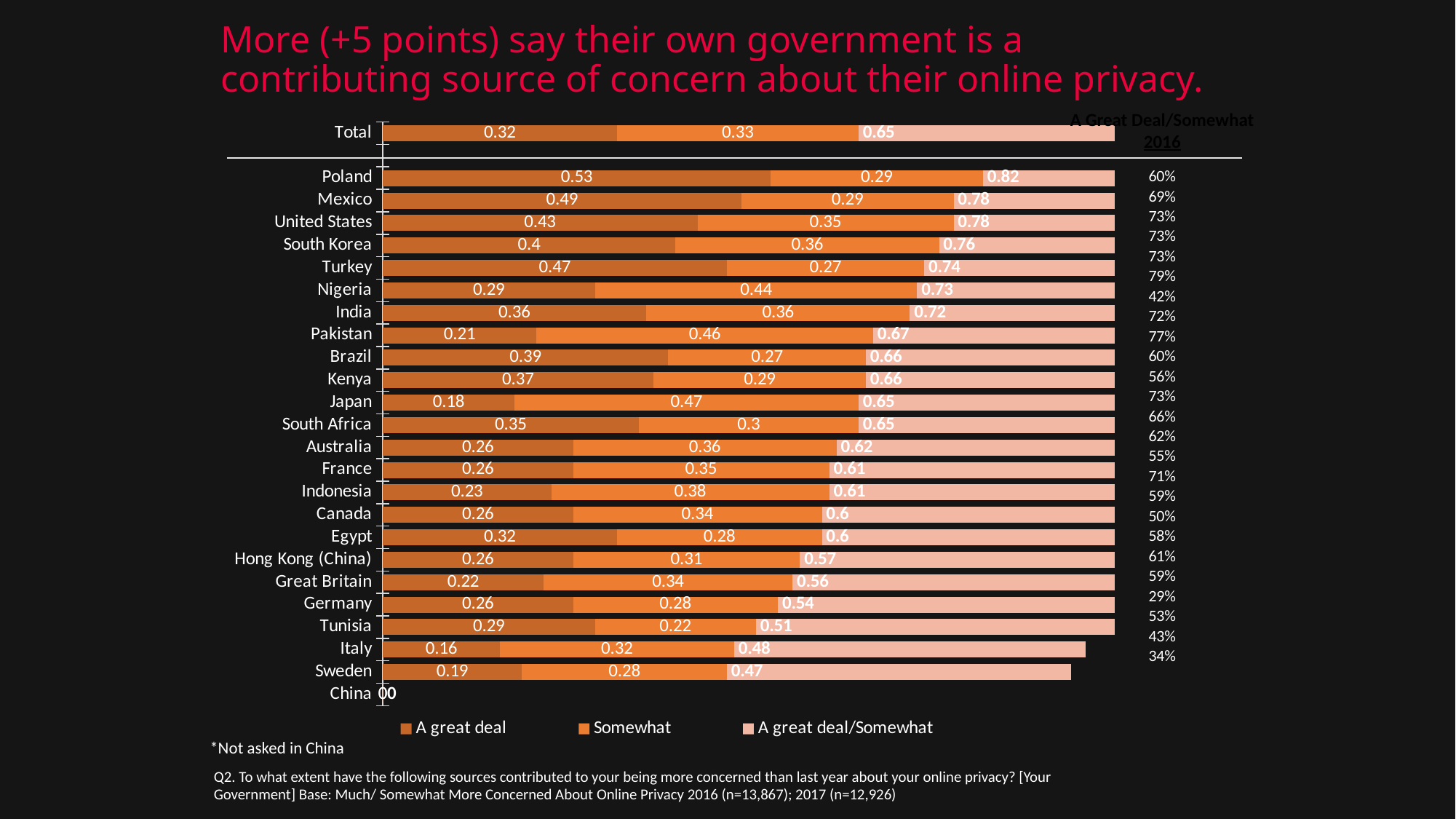
How many countries (excluding Total) are listed on the chart's axis? 24 What is the "A great deal/Somewhat" value for Nigeria? 0.73 Which country has the highest "A great deal/Somewhat" value? Poland Among the countries with plotted values, which has the lowest "A great deal/Somewhat" value? Sweden What is the difference between the "A great deal" values for Poland and Japan? 0.35 According to the footnote, in which country was the question not asked? China What is the "Somewhat" value for Japan? 0.47 Which has a larger "A great deal" value, Mexico or the United States? Mexico What is the value of "A great deal" for Poland? 0.53 What kind of chart is shown on the slide? Bar chart How many series does the legend list? 3 What is the "Somewhat" value for Total? 0.33